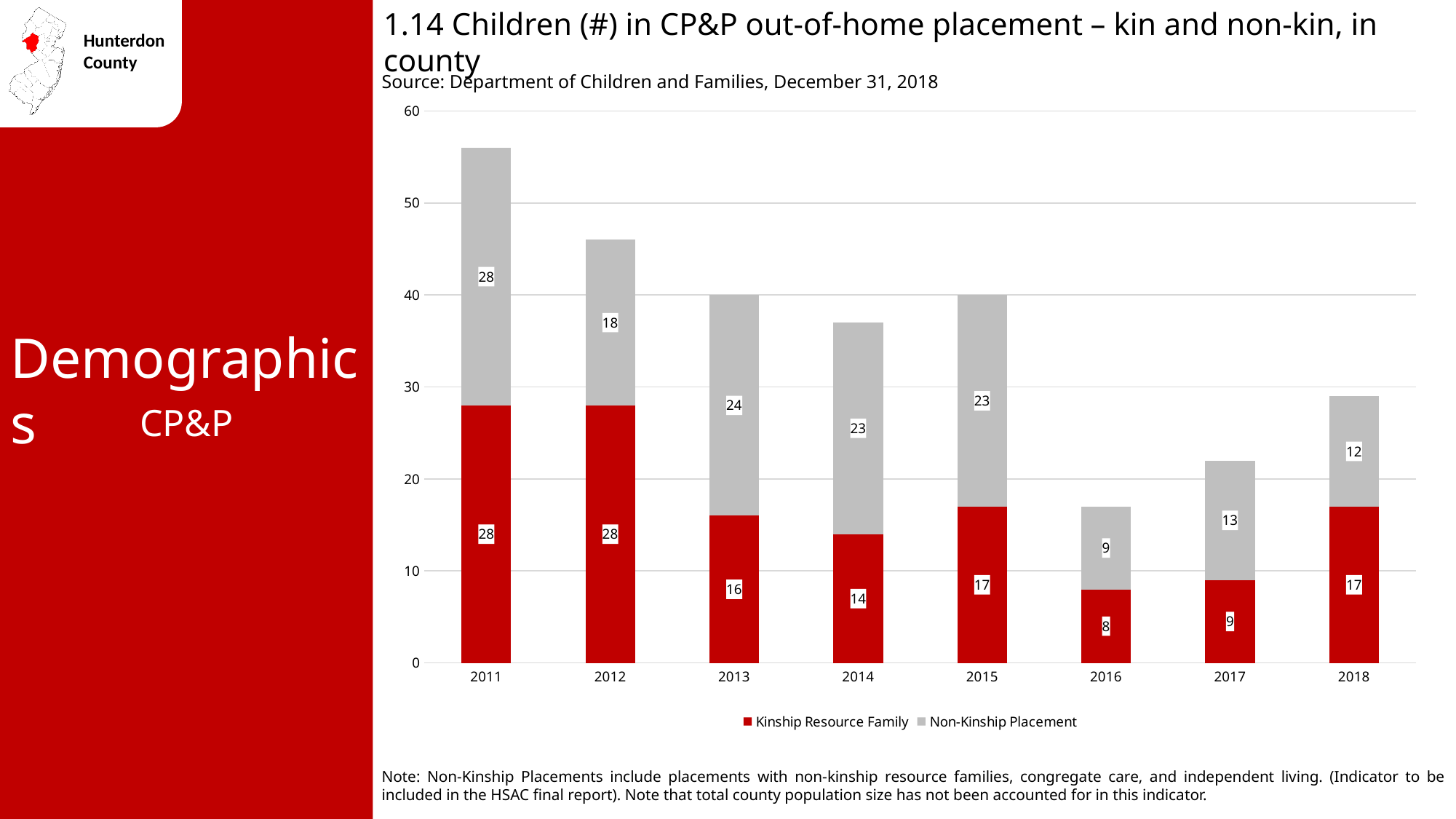
What is the Non-Kinship Placement value for 2011? 28 What is the total of the stacked bar for 2016? 17 What is the Kinship Resource Family value for 2013? 16 Which is larger, the Kinship Resource Family value for 2014 or for 2017? 2014 Which year has the lowest Kinship Resource Family value? 2016 What kind of chart is shown on the slide? Stacked bar chart What is the Non-Kinship Placement value for 2018? 12 What is the total of the stacked bar for 2012? 46 Which year has the highest Non-Kinship Placement value? 2011 How many years are shown on the x axis? 8 What is the difference between the Non-Kinship Placement values for 2015 and 2016? 14 How many series does the legend list? 2